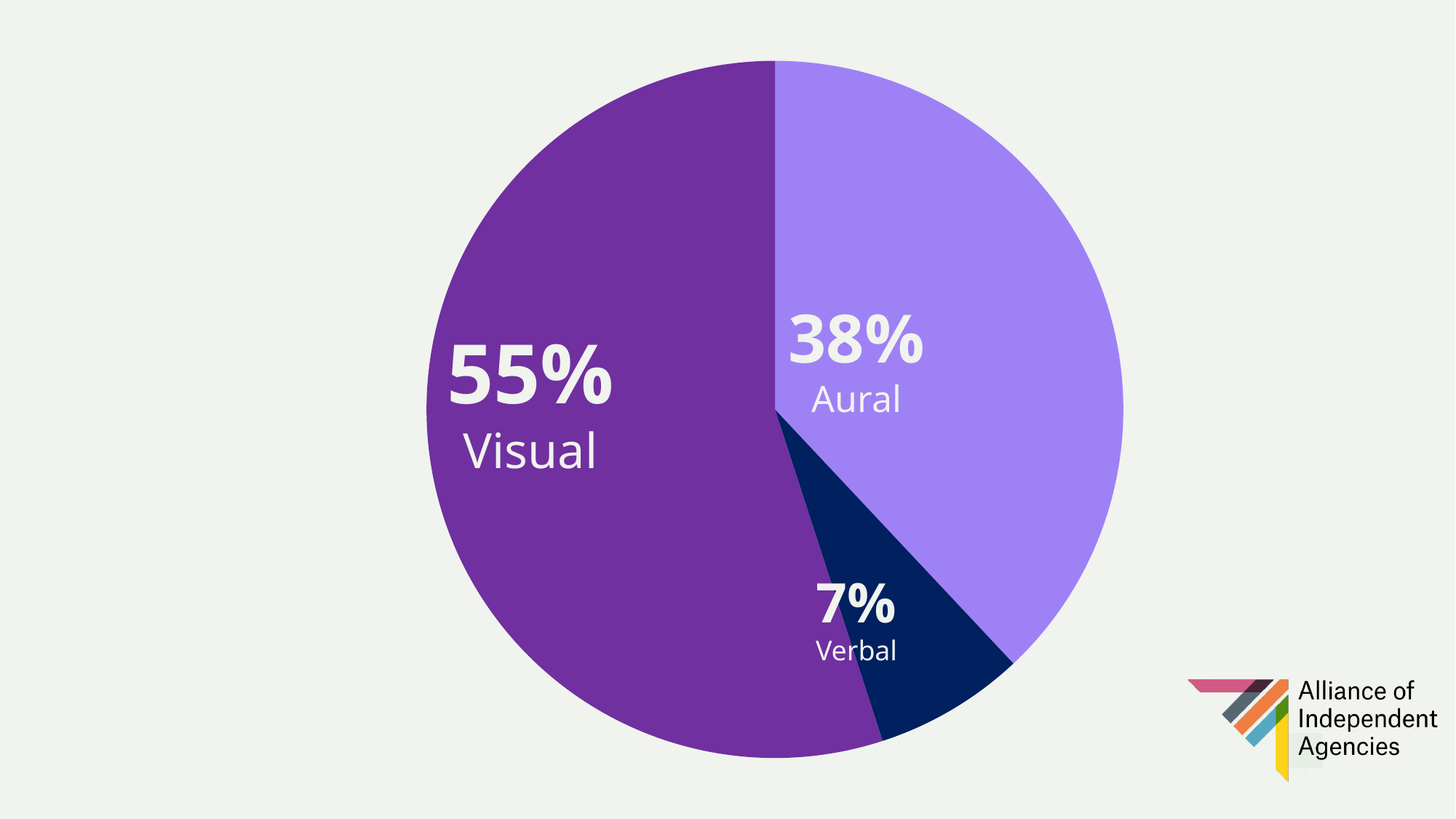
Which slice is the smallest? Verbal What percentage does the Visual slice represent? 55% What is the combined percentage of Aural and Verbal? 45% What is the difference between the Aural and Verbal percentages? 31% What percentage does the Aural slice represent? 38% What kind of chart is shown on the slide? pie chart What percentage does the Verbal slice represent? 7% What colour is the Verbal slice? dark navy blue What is the difference between the Visual and Aural percentages? 17% Which slice is the largest? Visual How many slices does the pie chart have? 3 Which is larger, Aural or Verbal? Aural